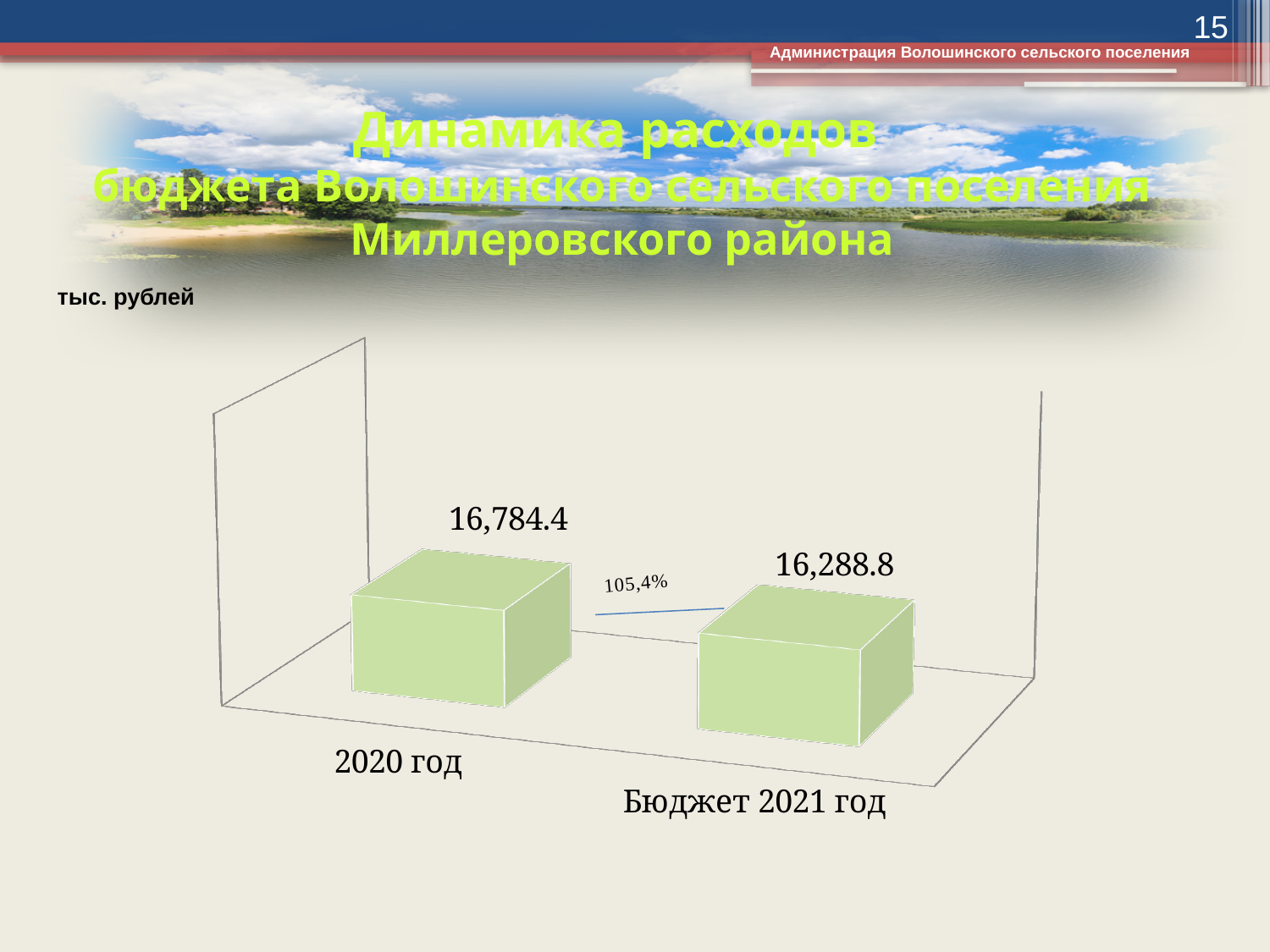
What is the value shown for Бюджет 2021 год? 16,288.8 Do the values rise or fall from 2020 год to Бюджет 2021 год? fall What is the difference between the value for 2020 год and the value for Бюджет 2021 год? 495.6 Which category has the highest value on the chart? 2020 год In what units are the chart values expressed, according to the label above the chart? тыс. рублей What is the value shown for 2020 год? 16,784.4 What percentage is written on the line connecting the two bars? 105,4% Which category has the lowest value on the chart? Бюджет 2021 год Which category has the higher value, 2020 год or Бюджет 2021 год? 2020 год How many categories are plotted on the chart? 2 What kind of chart is shown on the slide? bar chart